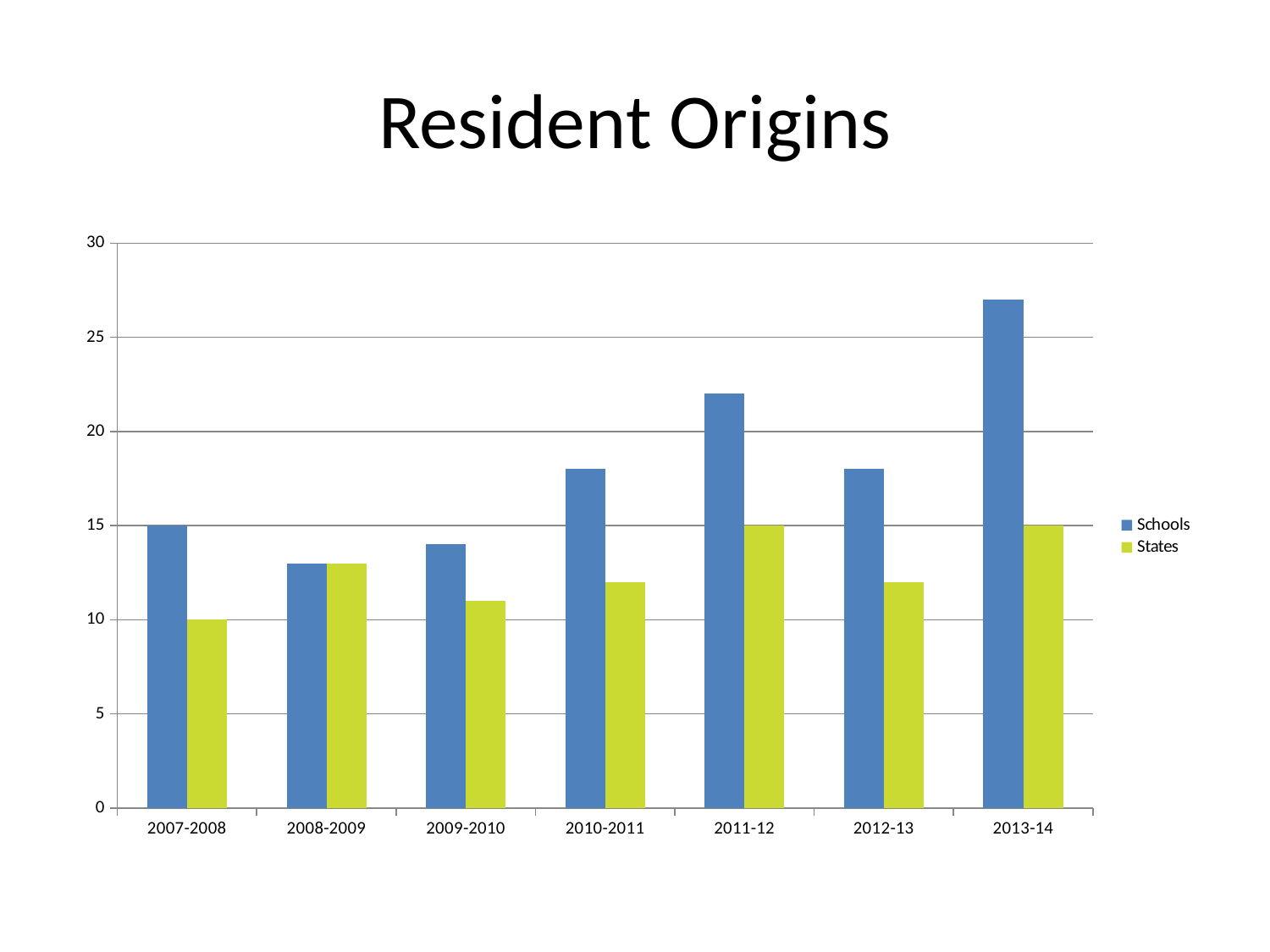
How many series does the legend list? 2 In 2013-14, which is larger, Schools or States? Schools In which year is the Schools value highest? 2013-14 What is the title of the chart? Resident Origins What is the value for States in 2011-12? 15 Is the value for Schools in 2013-14 greater or less than 25? greater What type of chart is shown on the slide? bar chart Is the value for Schools in 2010-2011 greater or less than 20? less What is the value for States in 2007-2008? 10 How many year categories are shown on the x axis? 7 Which series is shown in blue? Schools What is the value for Schools in 2007-2008? 15